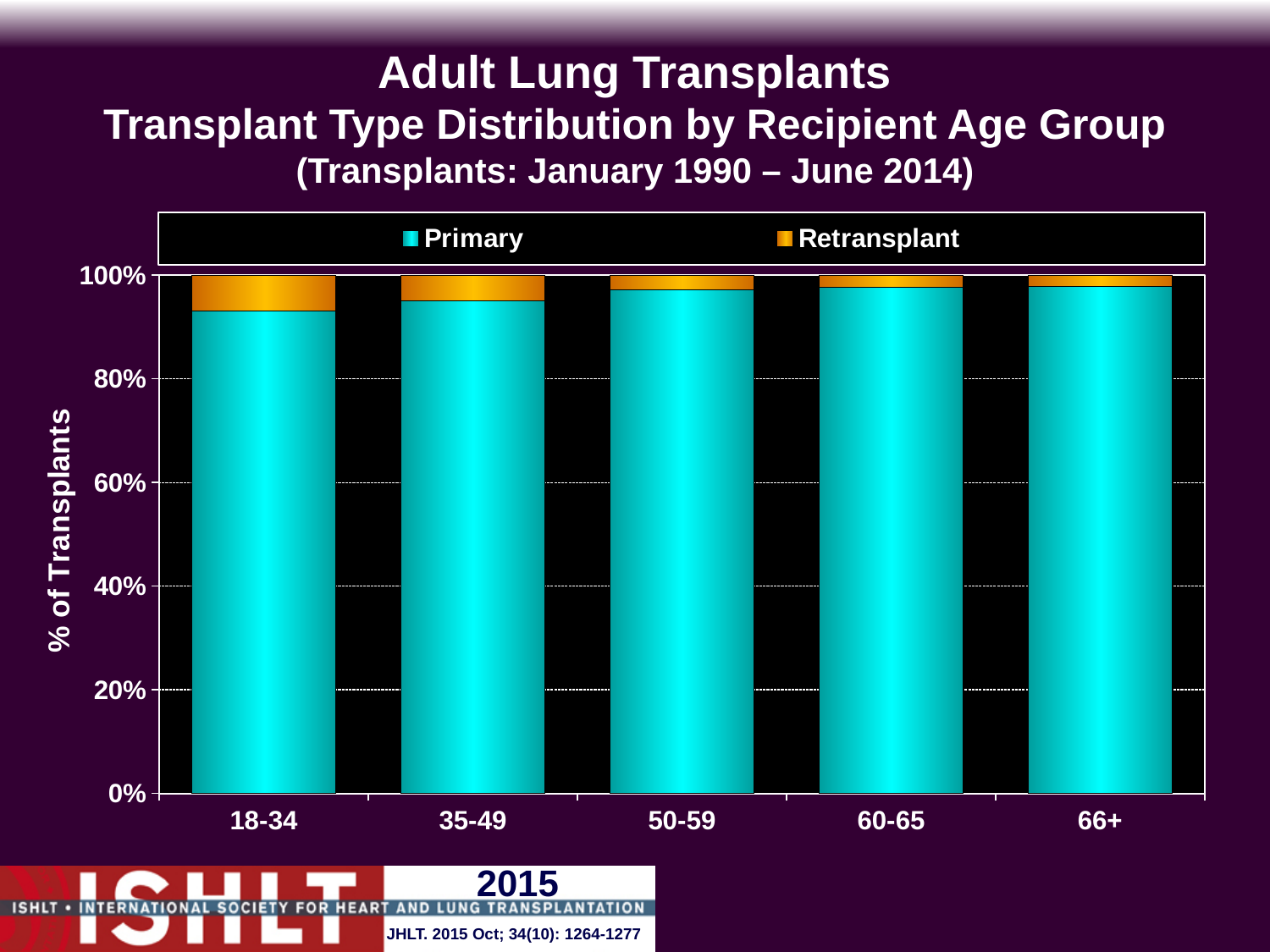
What are the two series named in the legend? Primary and Retransplant Is the Primary share for the 18-34 age group greater or less than 80%? greater Which age group has the largest Retransplant share? 18-34 What kind of chart is shown on the slide? Stacked bar chart What is the total height of each stacked bar? 100% How many series does the legend list? 2 Is the Retransplant share for the 66+ age group greater or less than 20%? less Which age group has the smallest Primary share? 18-34 What is the label of the y axis? % of Transplants Which age group has a larger Retransplant share, 18-34 or 66+? 18-34 How many recipient age groups are shown on the x axis? 5 Does the Primary share rise or fall from the 18-34 group to the 50-59 group? rise